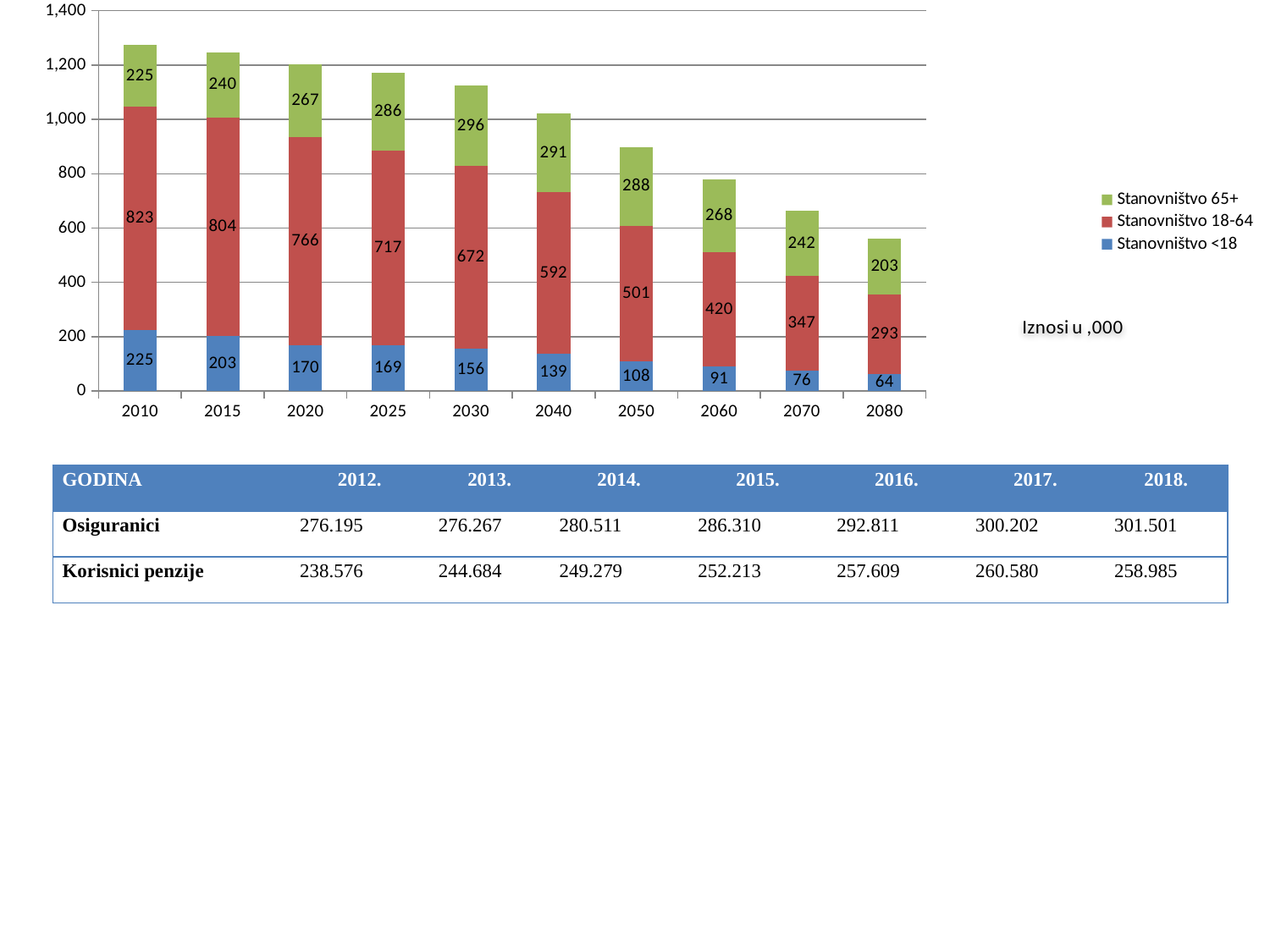
What is the value for Stanovništvo 18-64 in 2010? 823 What is the value for Stanovništvo <18 in 2040? 139 How many series does the chart legend list? 3 What kind of chart is shown on the slide? Stacked bar chart What is the total of the stacked bar for 2080? 560 How many years are shown on the x axis of the chart? 10 In which year is the Stanovništvo <18 segment the lowest? 2080 In which year is the Stanovništvo 65+ segment the highest? 2030 Is the total height of the 2070 bar greater or less than 600? greater What is the value for Stanovništvo 65+ in 2080? 203 What is the difference between the Stanovništvo 18-64 values for 2010 and 2080? 530 Which is larger, the Stanovništvo 65+ value for 2020 or for 2070? 2020